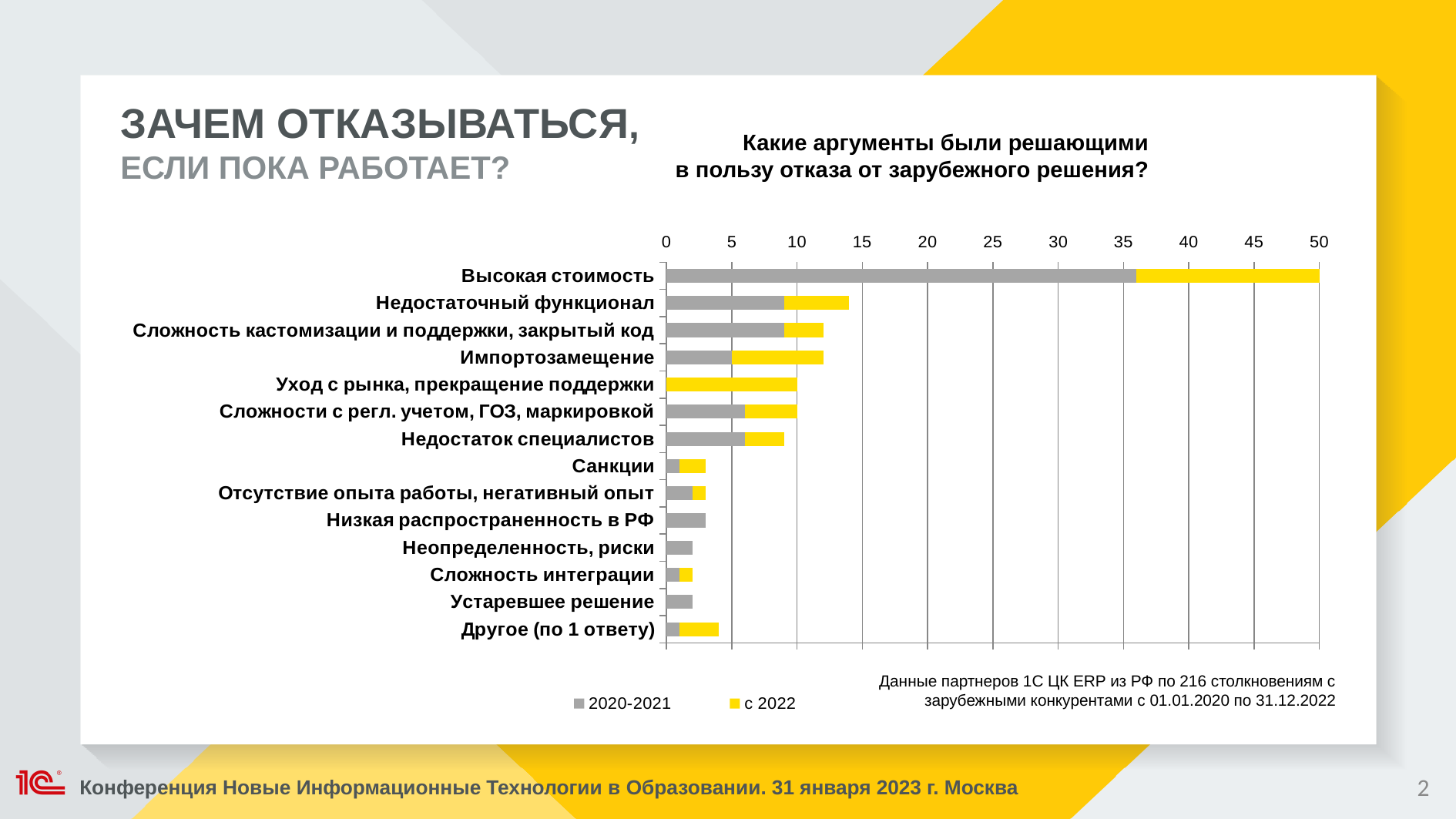
Is the total value for 'Санкции' greater or less than 5? less What are the two series named in the legend? 2020-2021 and с 2022 How many categories (arguments) are plotted on the chart? 14 Is the total value for 'Недостаточный функционал' greater or less than 10? greater What is the total value of the bar for 'Высокая стоимость'? 50 What kind of chart is shown on the slide? Stacked horizontal bar chart Which argument has the highest total value on the chart? Высокая стоимость What is the total value of the bar for 'Уход с рынка, прекращение поддержки'? 10 Is the total value for 'Недостаток специалистов' greater or less than 5? greater What is the title of the chart? Какие аргументы были решающими в пользу отказа от зарубежного решения? How many series does the chart legend list? 2 Which has a larger total value: 'Высокая стоимость' or 'Недостаточный функционал'? Высокая стоимость